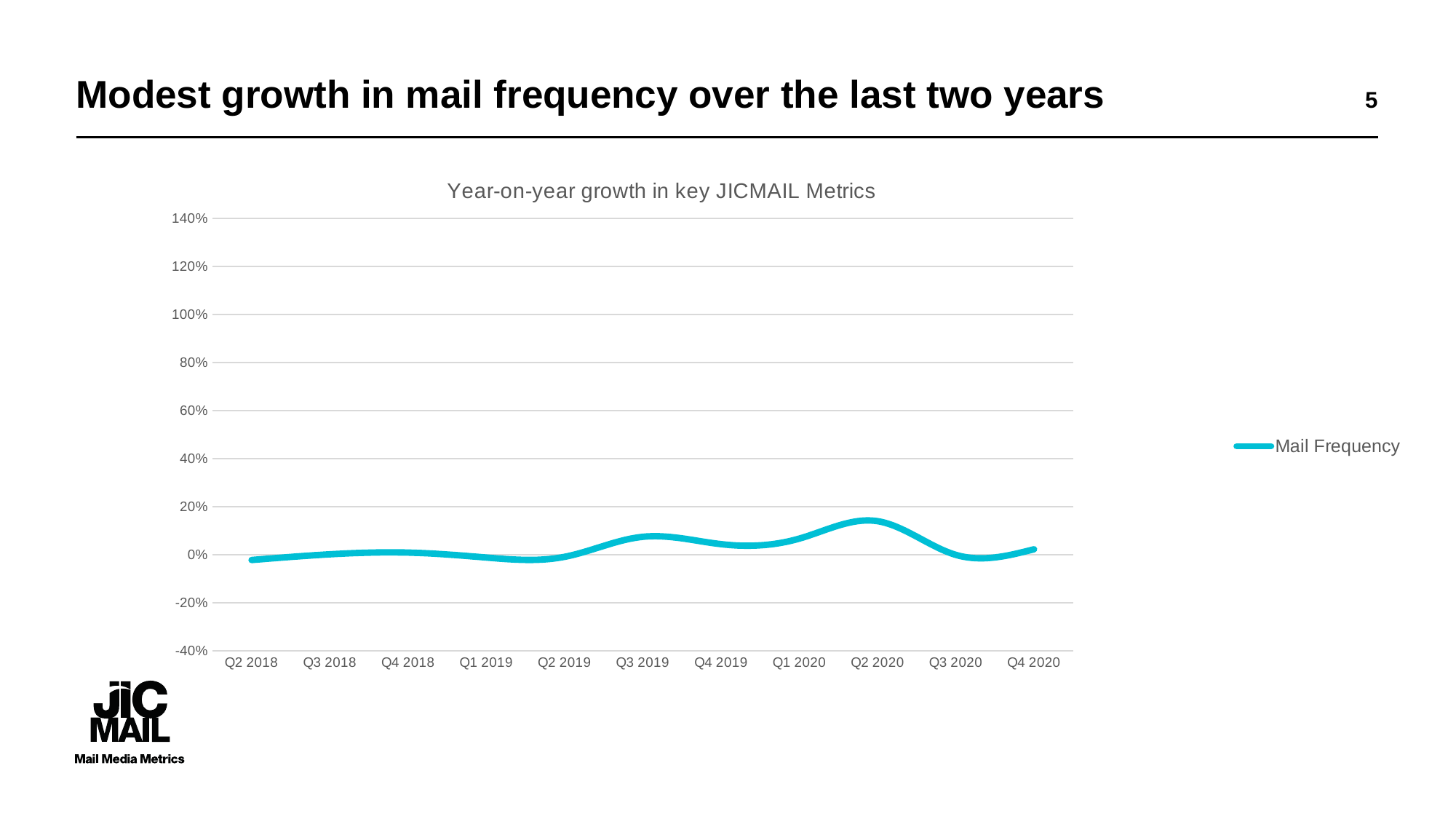
How many quarters are plotted along the x axis? 11 Which is larger, the Mail Frequency value for Q2 2020 or for Q3 2020? Q2 2020 What is the name of the series shown in the legend? Mail Frequency Is the Mail Frequency value for Q2 2020 greater or less than 0%? greater How many series does the legend list? 1 What kind of chart is shown on the slide? Line chart Is the Mail Frequency value for Q3 2019 greater or less than 0%? greater Does the Mail Frequency line rise or fall from Q2 2020 to Q3 2020? Fall Which is larger, the Mail Frequency value for Q3 2019 or for Q2 2019? Q3 2019 In which quarter is Mail Frequency growth highest? Q2 2020 What is the title of the chart? Year-on-year growth in key JICMAIL Metrics Is the Mail Frequency value for Q2 2020 greater or less than 20%? less